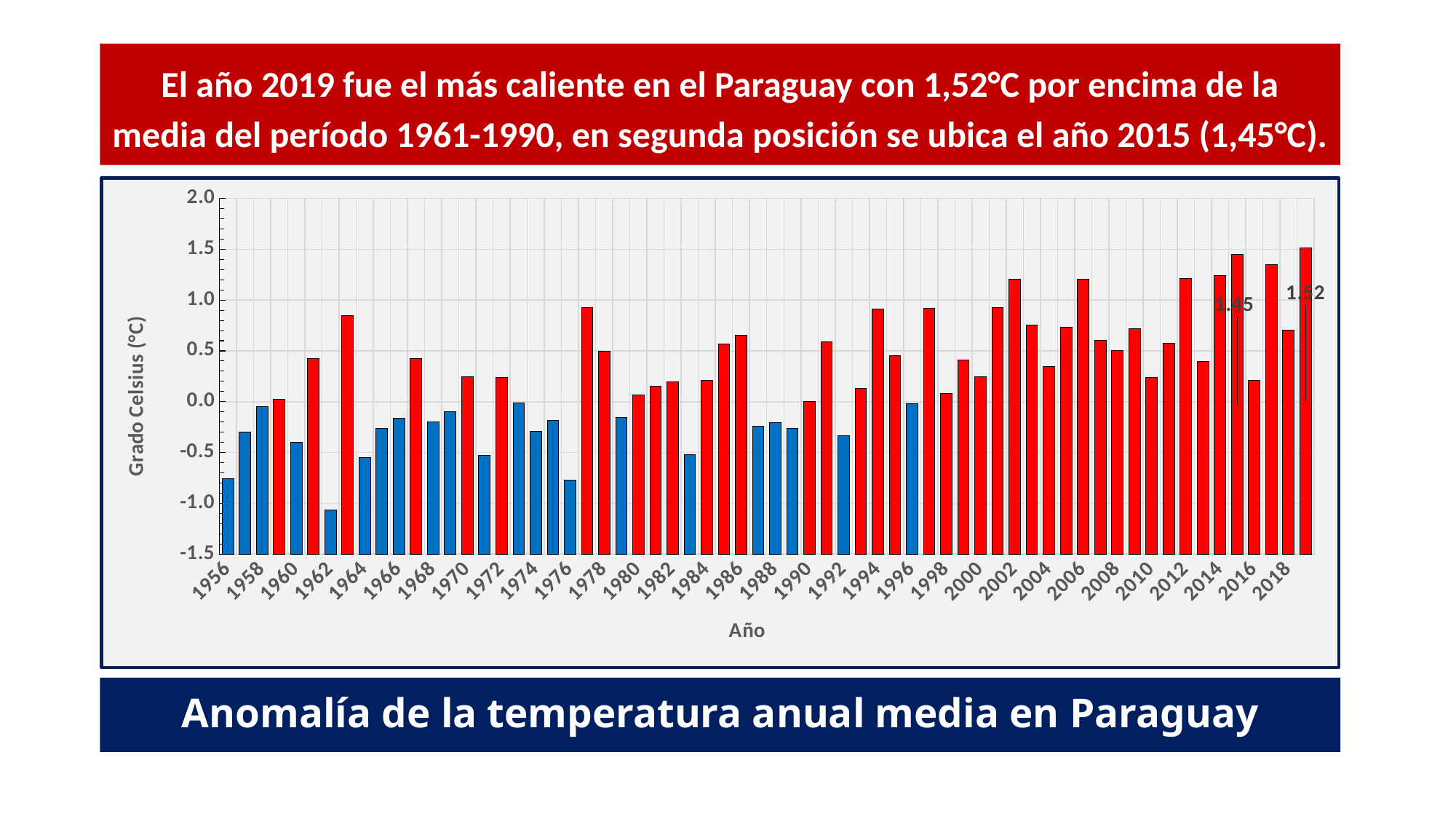
What kind of chart is shown on the slide? bar chart What is the temperature anomaly value labelled for 2019? 1.52 What is the difference between the labelled anomaly values for 2019 and 2015? 0.07 What is the temperature anomaly value labelled for 2015? 1.45 What is the title of the vertical axis of the chart? Grado Celsius (°C) Do the temperature anomaly values generally rise or fall from 1956 to 2019? rise Is the value for 1956 greater or less than -0.5? less Is the value for 1962 greater or less than -1.0? less Which year has the highest temperature anomaly? 2019 Which year has the larger anomaly, 2015 or 2019? 2019 Is the value for 2003 greater or less than 1.0? less Which year has the lowest temperature anomaly? 1962